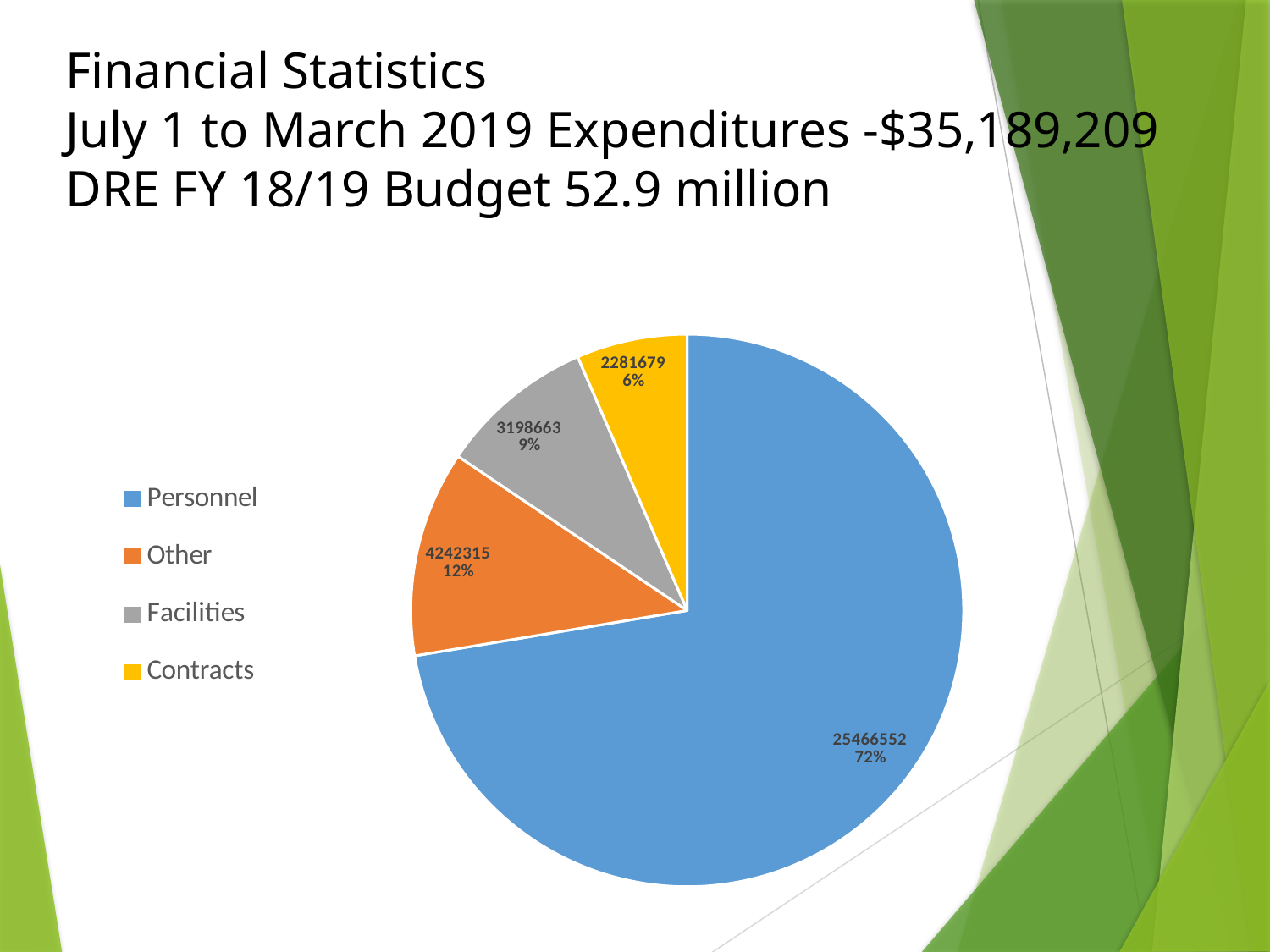
What is the value for Other? 4242315 What is the value for Personnel? 25466552 What kind of chart is shown on the slide? pie chart Which category has the smallest slice? Contracts What is the value for Contracts? 2281679 What share of the pie does Personnel represent? 72% How many categories does the legend list? 4 What is the value for Facilities? 3198663 What share of the pie does Facilities represent? 9% Which is larger, the value for Facilities or the value for Contracts? Facilities What is the difference between the values for Other and Facilities? 1043652 Which category has the largest slice? Personnel